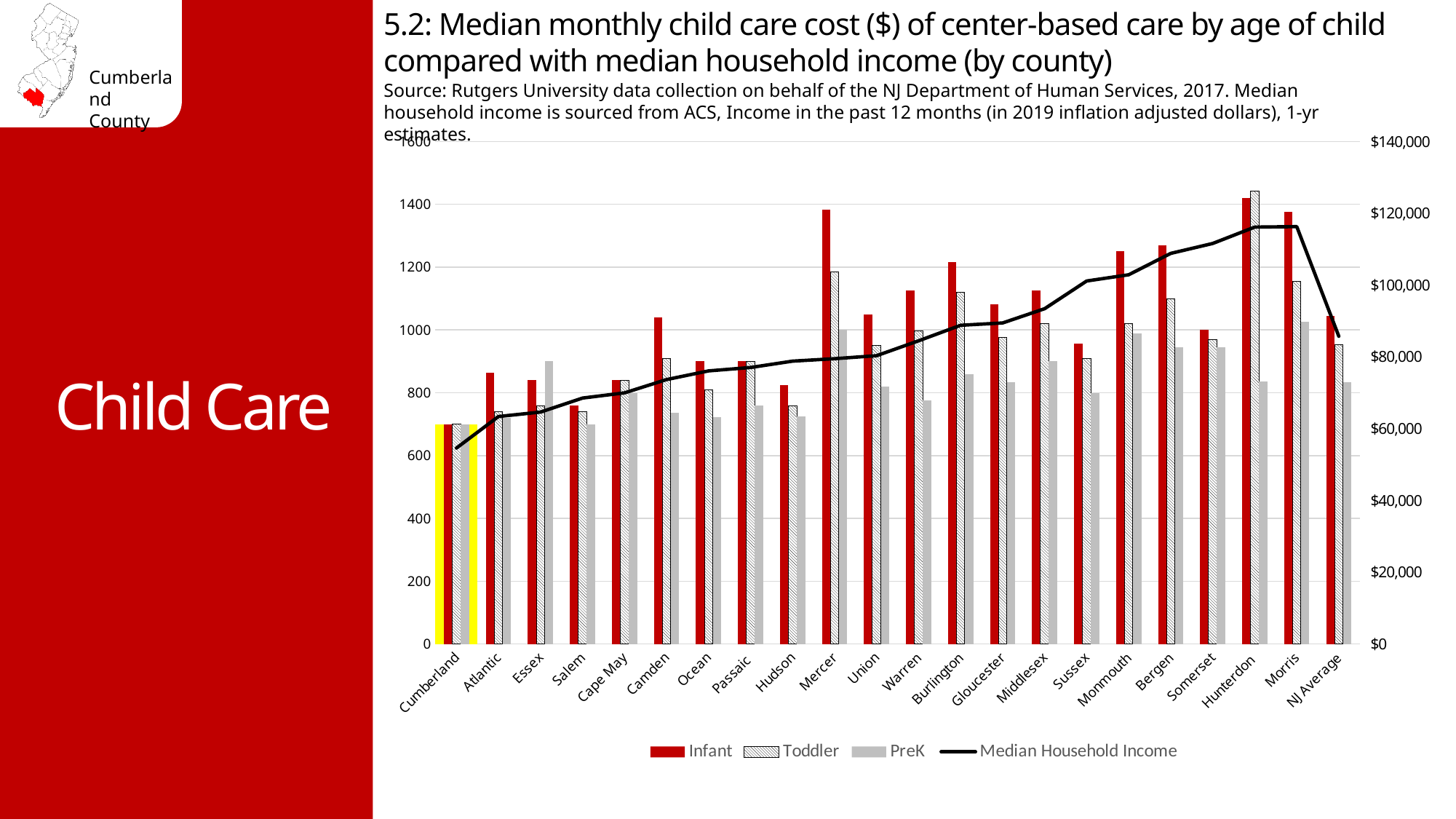
How many series does the legend list? 4 Which is larger, the Median Household Income for Cumberland or for Morris? Morris Is the Median Household Income for Morris greater or less than $100,000? greater Which is larger, the Infant value for Mercer or the Infant value for Camden? Mercer Which category has the highest Toddler value? Hunterdon Is the Infant value for Cumberland greater or less than 800? less Does the Median Household Income line generally rise or fall from Cumberland to Morris? rise How many categories are shown along the x axis? 22 Which category has the lowest Median Household Income? Cumberland What kind of chart is shown on the slide? Bar chart with a line Which category's bars are highlighted in yellow? Cumberland Is the Infant value for Mercer greater or less than 1200? greater